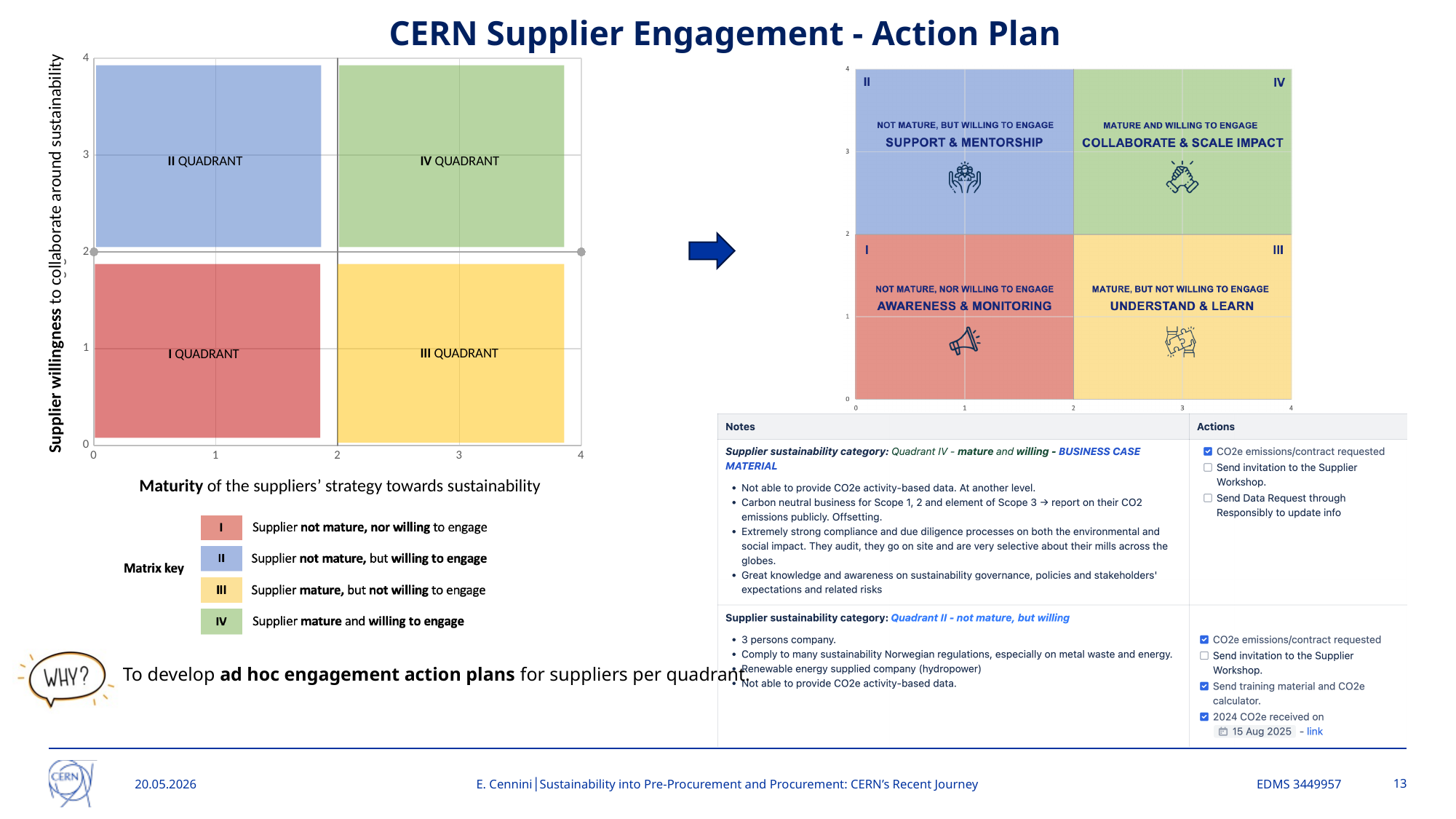
On the left chart, what is the label of the y axis? Supplier willingness to collaborate around sustainability On the right chart, what action title is given for quadrant IV? COLLABORATE & SCALE IMPACT How many quadrants are shown in the left chart? 4 On the left chart, which quadrant occupies the bottom-left region? I QUADRANT On the left chart, which quadrant occupies the top-right region? IV QUADRANT On the left chart, at what x-axis value is the vertical dividing line between the quadrants placed? 2 On the left chart, what is the maximum value shown on the x axis? 4 On the right chart, what action title is given for quadrant I? AWARENESS & MONITORING On the right chart, what action title is given for quadrant III? UNDERSTAND & LEARN On the left chart, what is the label of the x axis? Maturity of the suppliers' strategy towards sustainability On the left chart, which quadrant occupies the top-left region? II QUADRANT On the left chart, which quadrant occupies the bottom-right region? III QUADRANT